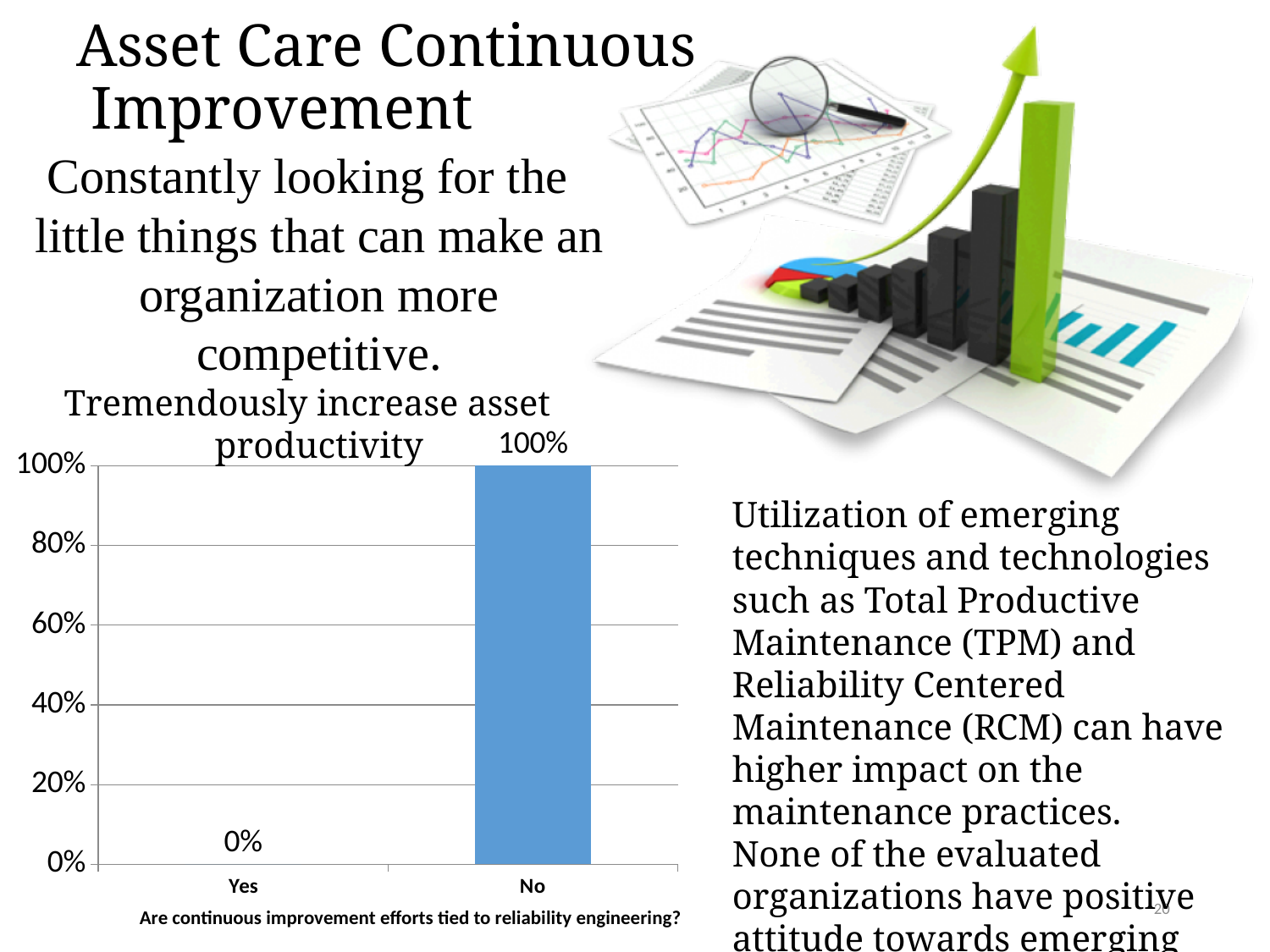
What is the highest tick value shown on the y axis of the chart? 100% What is the x-axis title of the chart? Are continuous improvement efforts tied to reliability engineering? What kind of chart is shown on the slide? bar chart How many categories are shown on the x axis of the chart? 2 Is the value for "No" greater or less than 80%? greater Which category has the highest value in the chart? No What is the value for "No" in the chart? 100% What is the value for "Yes" in the chart? 0% Which category has the lowest value in the chart? Yes Which is larger, the value for "Yes" or the value for "No"? No What is the difference between the values for "No" and "Yes"? 100%